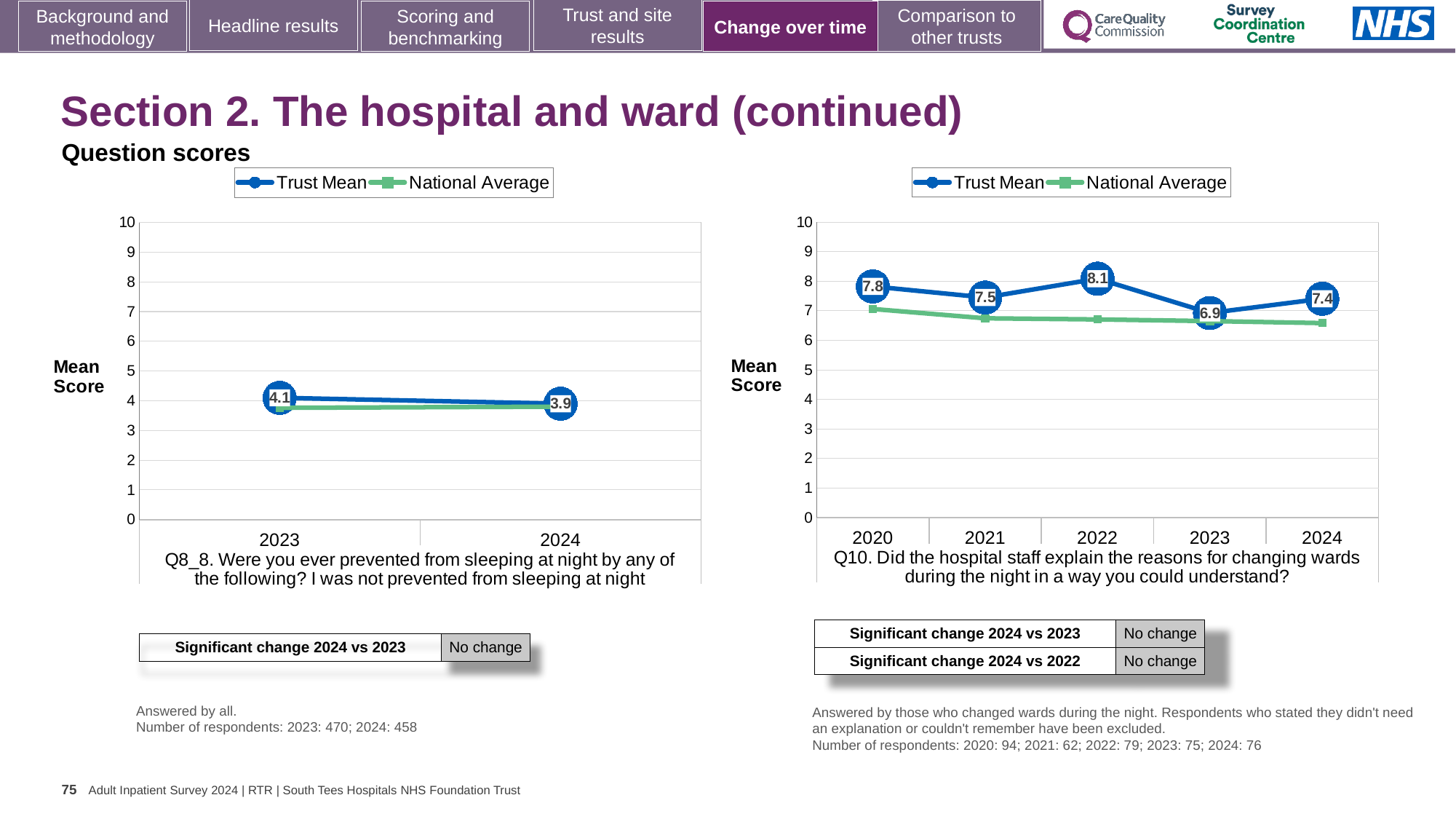
In the right chart (Q10), which year has the highest Trust Mean score? 2022 How many years are plotted on the x axis of the right chart (Q10)? 5 In the left chart (Q8_8), what is the Trust Mean score for 2024? 3.9 In the right chart (Q10), is the National Average for 2024 greater or less than 7? less In the left chart (Q8_8), by how much did the Trust Mean change from 2023 to 2024? 0.2 In the left chart (Q8_8), what is the Trust Mean score for 2023? 4.1 In the right chart (Q10), which year has the lowest Trust Mean score? 2023 In the left chart (Q8_8), does the Trust Mean rise or fall from 2023 to 2024? fall In the right chart (Q10), what is the Trust Mean score for 2022? 8.1 In the right chart (Q10), what is the difference between the Trust Mean in 2020 and in 2024? 0.4 In the right chart (Q10), is the Trust Mean higher in 2021 or in 2023? 2021 What type of chart is the left chart (Q8_8)? line chart